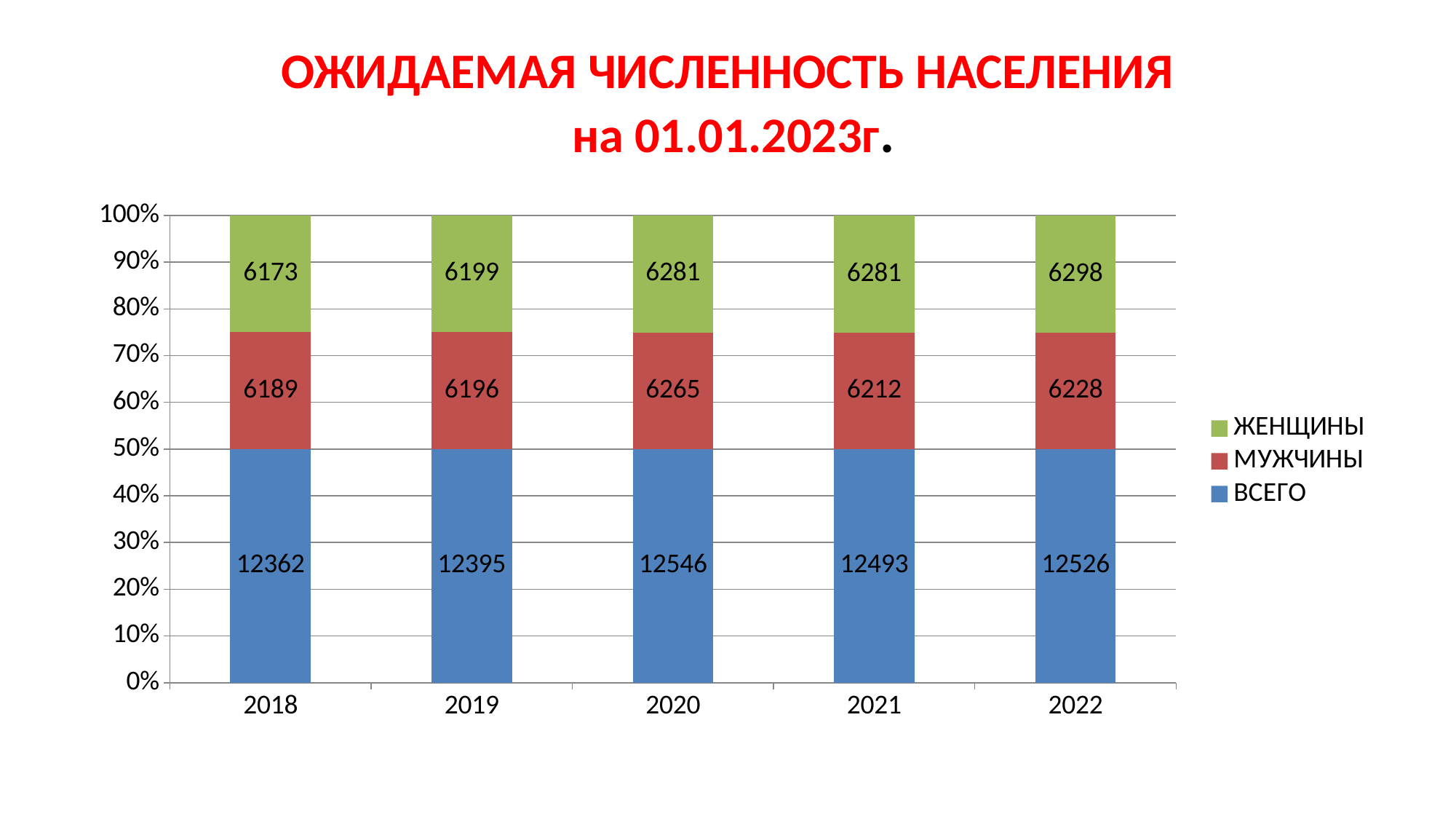
How many years are shown on the x axis? 5 What is the value for ЖЕНЩИНЫ in 2022? 6298 In which year is the ЖЕНЩИНЫ value highest? 2022 What is the value for ВСЕГО in 2020? 12546 How many series does the legend list? 3 What is the difference between the МУЖЧИНЫ values for 2020 and 2021? 53 What is the value for МУЖЧИНЫ in 2019? 6196 In which year is the ВСЕГО value lowest? 2018 In 2021, which is larger: the ЖЕНЩИНЫ value or the МУЖЧИНЫ value? ЖЕНЩИНЫ What kind of chart is shown on the slide? Stacked bar chart What is the difference between the ВСЕГО values for 2020 and 2018? 184 In which year is the ВСЕГО value highest? 2020